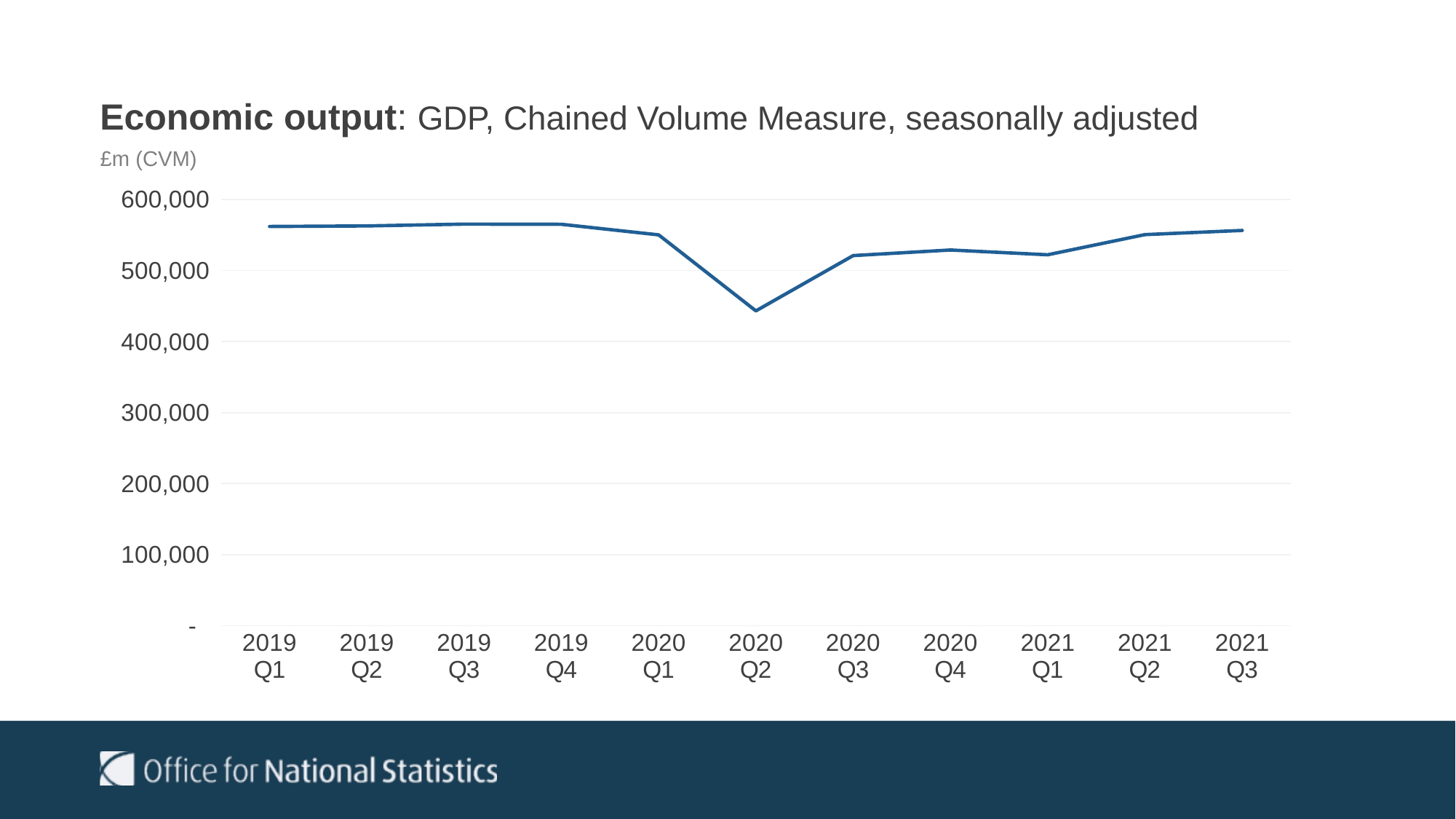
Which is larger, the value for 2020 Q3 or the value for 2021 Q3? 2021 Q3 What unit is shown on the y axis label? £m (CVM) Which quarter has the lowest GDP value? 2020 Q2 How many quarters are plotted along the x axis? 11 Is the value for 2019 Q4 greater or less than 500,000? greater Do the values rise or fall from 2019 Q4 to 2020 Q2? fall Which is larger, the value for 2020 Q1 or the value for 2020 Q2? 2020 Q1 What kind of chart is shown on the slide? line chart Is the value for 2021 Q3 greater or less than 600,000? less Is the value for 2020 Q2 greater or less than 400,000? greater Do the values rise or fall from 2020 Q2 to 2020 Q3? rise